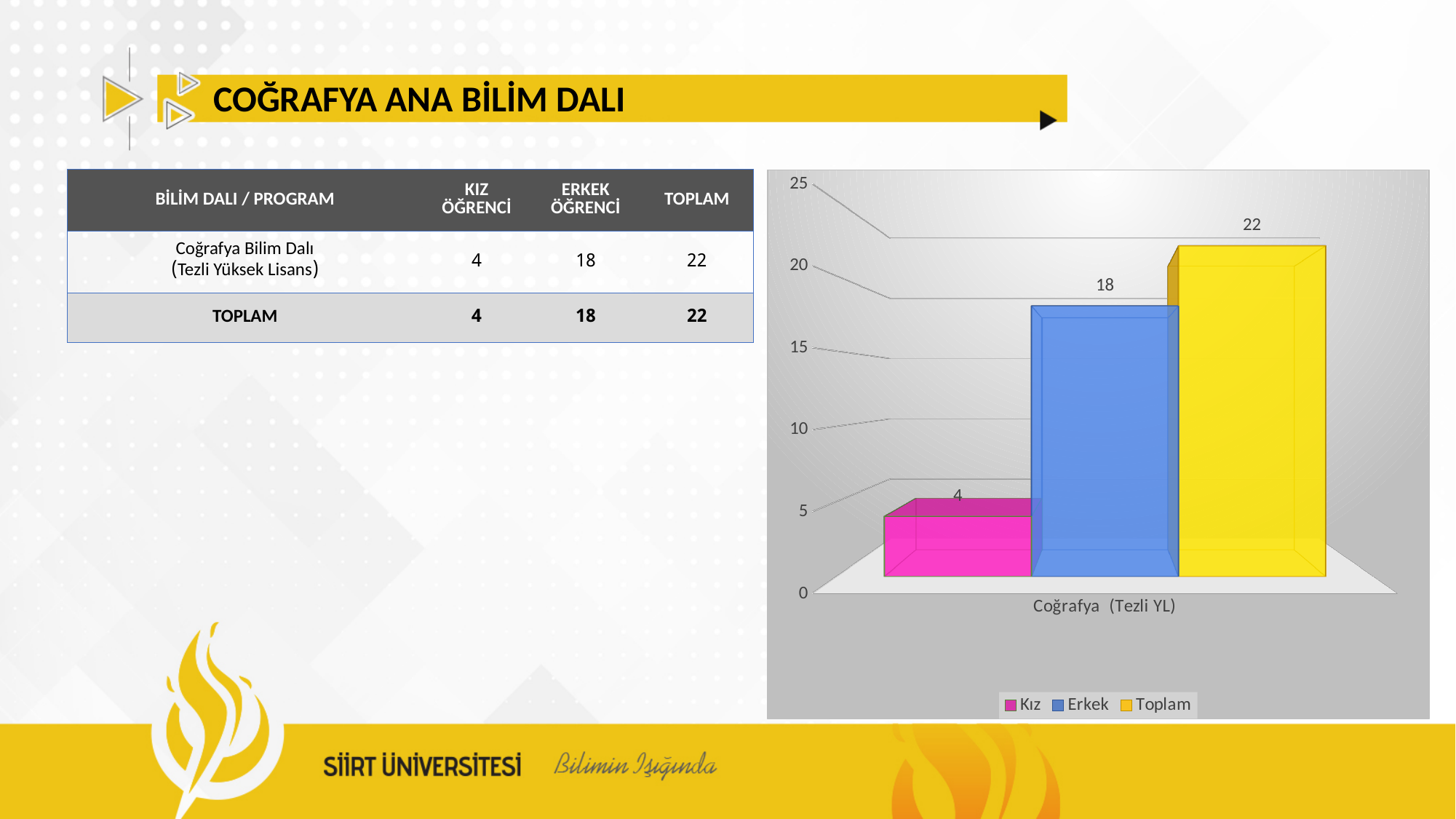
What is the value of the Toplam series for Coğrafya (Tezli YL) in the chart? 22 Which series has the lowest value in the chart? Kız What kind of chart is shown on the slide? bar chart Which is larger in the chart, the Kız value or the Erkek value? Erkek What colour is the Toplam series in the chart? yellow How many categories are shown on the x axis of the chart? 1 Is the Erkek value in the chart greater or less than 15? greater What is the value of the Erkek series for Coğrafya (Tezli YL) in the chart? 18 How many series does the chart legend list? 3 What is the value of the Kız series for Coğrafya (Tezli YL) in the chart? 4 Which series has the highest value in the chart? Toplam What is the difference between the Erkek and Kız values in the chart? 14